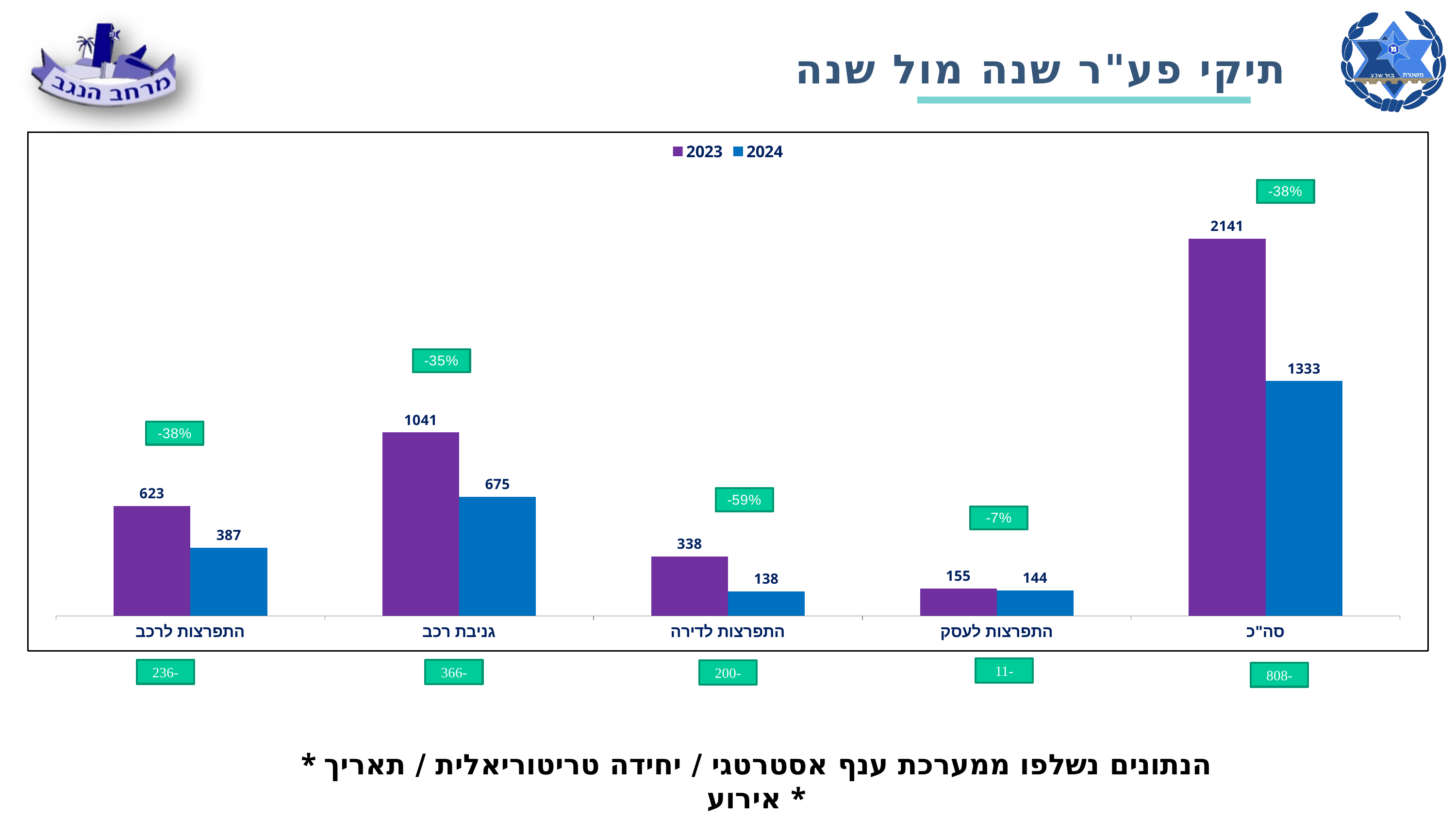
How many categories are shown on the x axis? 5 How many series does the legend list? 2 What is the 2024 value for התפרצות לדירה? 138 What is the difference between the 2023 and 2024 values for התפרצות לרכב? 236 What is the 2023 value for התפרצות לעסק? 155 What is the 2023 value for גניבת רכב? 1041 What percentage change label is shown above the התפרצות לדירה bars? -59% What is the 2024 value for סה"כ? 1333 Which is larger: the 2024 value for גניבת רכב or the 2023 value for התפרצות לרכב? 2024 value for גניבת רכב Excluding סה"כ, which category has the lowest 2024 value? התפרצות לדירה What kind of chart is shown on the slide? bar chart Excluding סה"כ, which category has the highest 2023 value? גניבת רכב